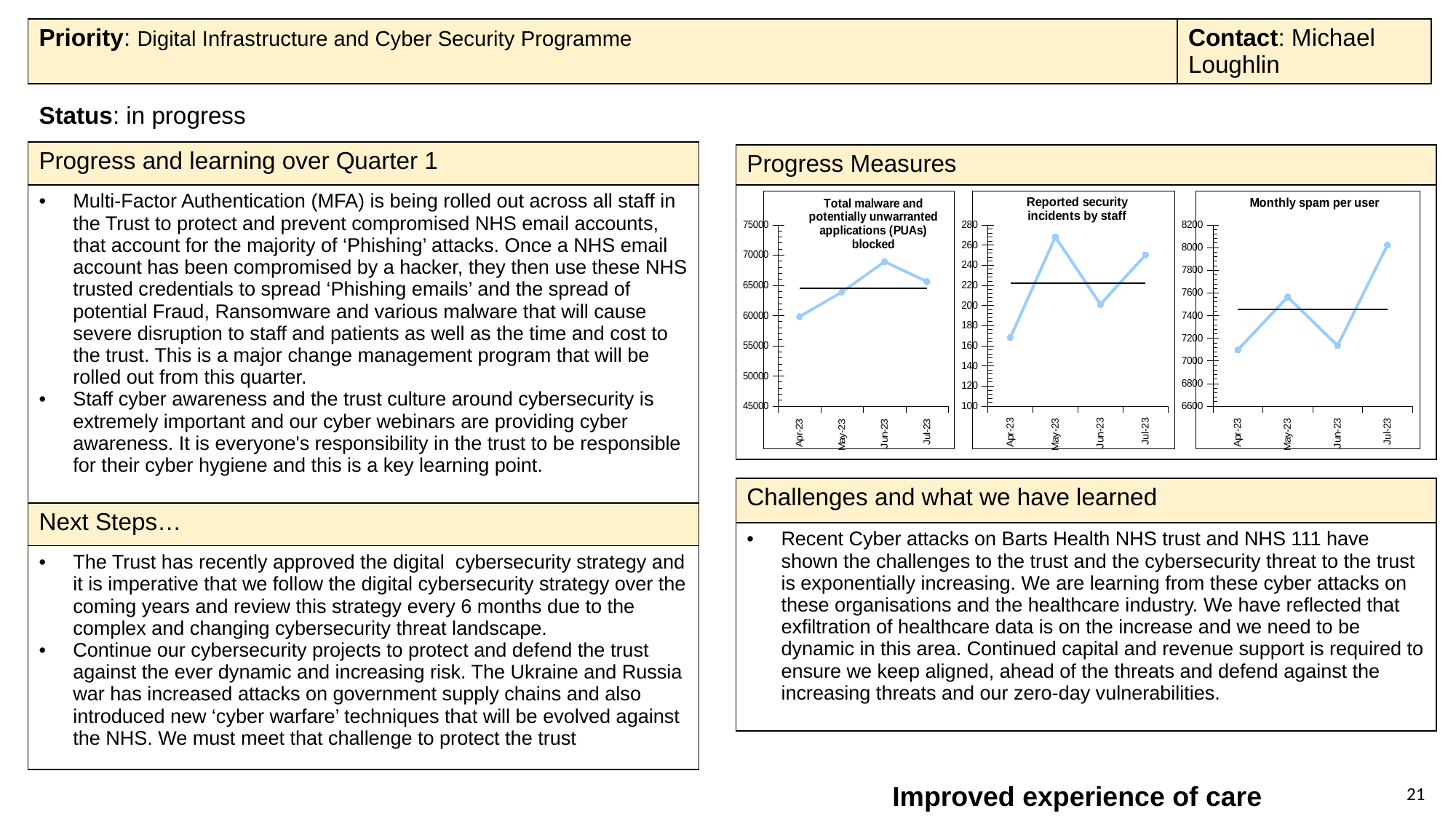
In the 'Total malware and potentially unwarranted applications (PUAs) blocked' chart, is the value for Apr-23 greater or less than 65000? less What kind of chart is the 'Monthly spam per user' chart? line chart In the 'Total malware and potentially unwarranted applications (PUAs) blocked' chart, which month has the lowest value? Apr-23 In the 'Total malware and potentially unwarranted applications (PUAs) blocked' chart, how many months are plotted? 4 How many charts are shown in the Progress Measures section? 3 In the 'Monthly spam per user' chart, is the value for Jul-23 greater or less than 7800? greater In the 'Reported security incidents by staff' chart, which month has the lowest value? Apr-23 In the 'Total malware and potentially unwarranted applications (PUAs) blocked' chart, which month has the highest value? Jun-23 In the 'Reported security incidents by staff' chart, is the value for Apr-23 greater or less than 200? less In the 'Reported security incidents by staff' chart, which month has the highest value? May-23 In the 'Reported security incidents by staff' chart, which is larger, the value for May-23 or Jun-23? May-23 In the 'Monthly spam per user' chart, which month has the highest value? Jul-23